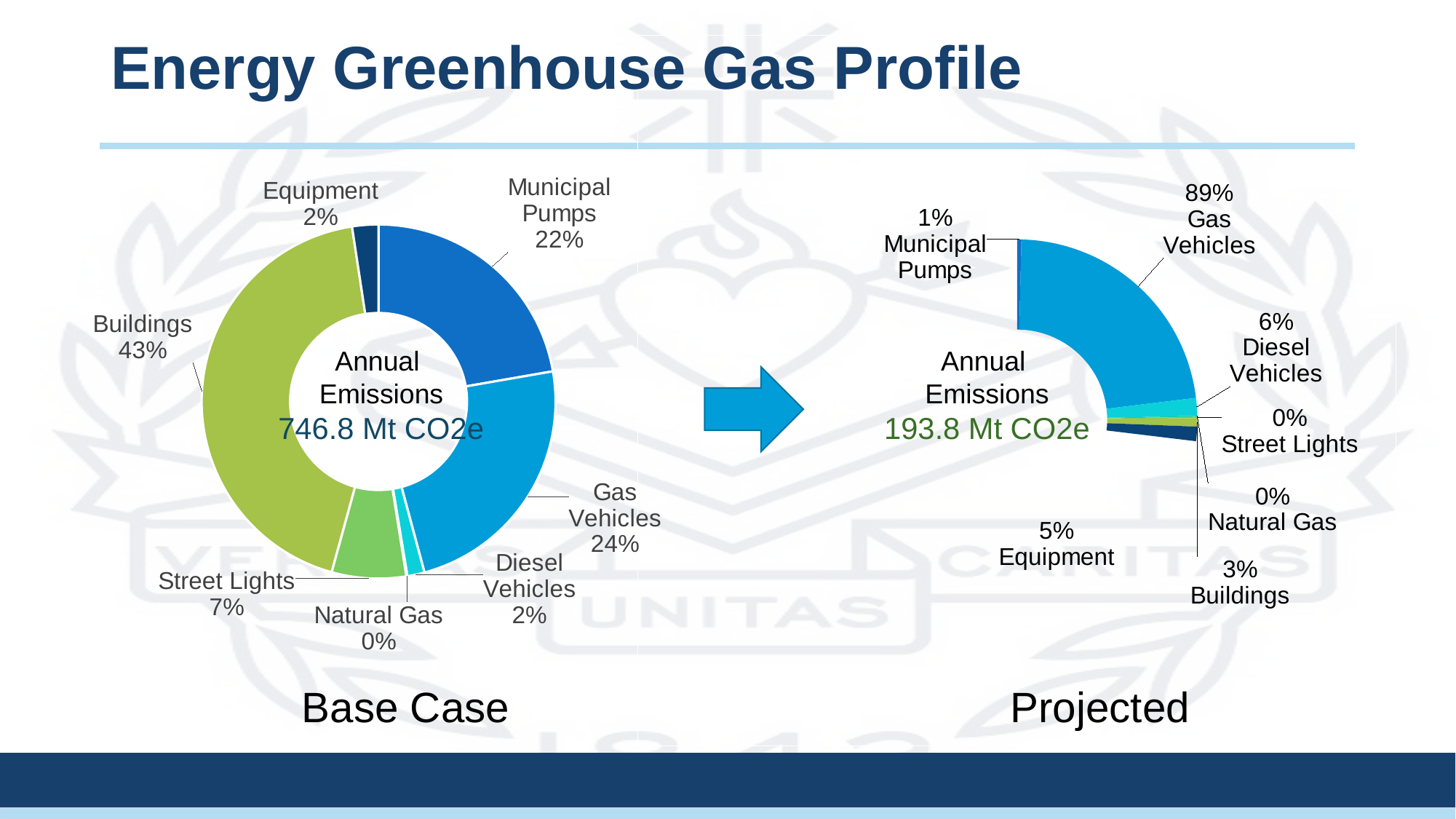
In the Base Case chart, which category has the largest share? Buildings What kind of chart is the Base Case chart? Doughnut (pie) chart In the Base Case chart, what share of annual emissions comes from Gas Vehicles? 24% In the Base Case chart, what is the difference in percentage points between Buildings and Municipal Pumps? 21 In the Base Case chart, what share of annual emissions comes from Buildings? 43% In the Base Case chart, what annual emissions value is shown in the centre? 746.8 Mt CO2e How many categories are shown in the Base Case chart? 7 In the Projected chart, what share of annual emissions comes from Gas Vehicles? 89% In the Projected chart, which category has the largest share? Gas Vehicles In the Projected chart, which is larger, the share for Diesel Vehicles or the share for Equipment? Diesel Vehicles In the Base Case chart, which category has the smallest share? Natural Gas In the Projected chart, what annual emissions value is shown in the centre? 193.8 Mt CO2e